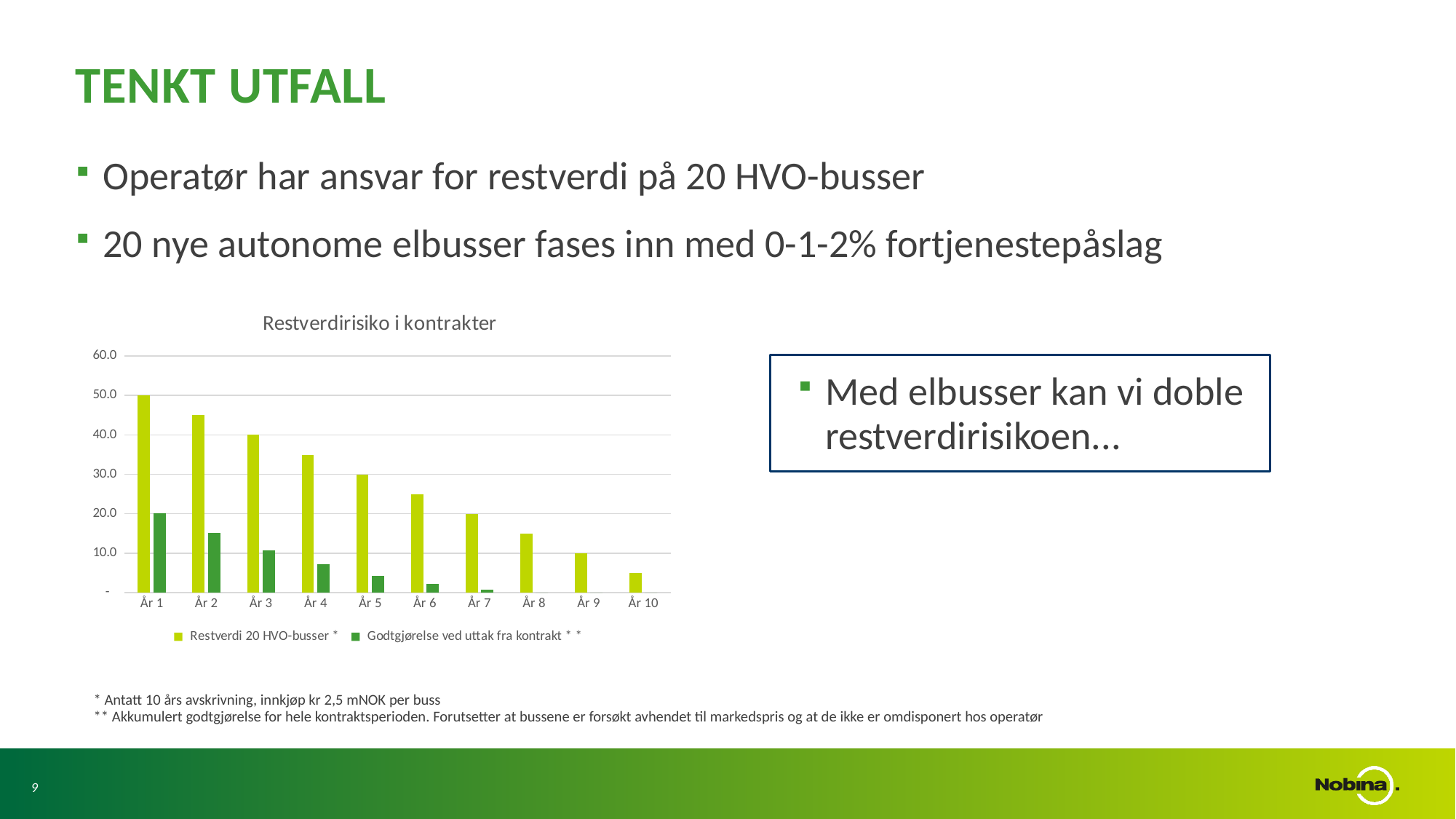
What kind of chart is shown under the title "Restverdirisiko i kontrakter"? bar chart Is the value of "Godtgjørelse ved uttak fra kontrakt" for År 4 greater or less than 10.0? less What is the value of "Restverdi 20 HVO-busser" for År 1? 50.0 What is the value of "Restverdi 20 HVO-busser" for År 5? 30.0 Is the value of "Restverdi 20 HVO-busser" for År 2 greater or less than 40.0? greater Do the values of "Restverdi 20 HVO-busser" rise or fall from År 1 to År 10? fall Which year has the lowest value for "Restverdi 20 HVO-busser"? År 10 How many series does the chart legend list? 2 How many categories (years) are shown on the x axis of the chart? 10 Which year has the highest value for "Restverdi 20 HVO-busser"? År 1